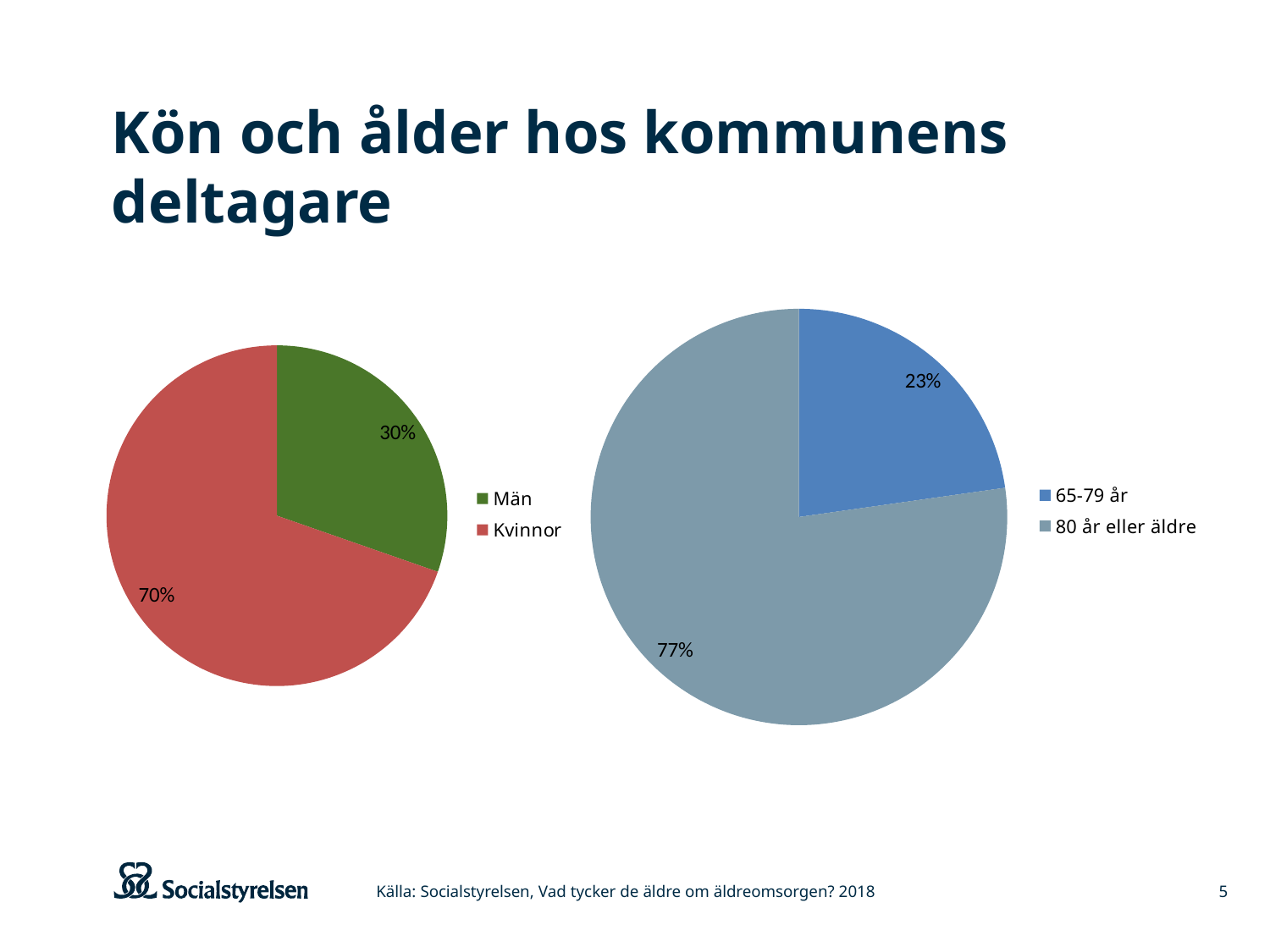
In the left pie chart, what colour is the Män slice? Green In the left pie chart, what share of participants are Kvinnor? 70% In the left pie chart, what share of participants are Män? 30% What type of chart is used on the right side of the slide? Pie chart In the right pie chart, what share of participants are 65-79 år? 23% How many slices does the left pie chart have? 2 In the right pie chart, which is larger: 65-79 år or 80 år eller äldre? 80 år eller äldre In the right pie chart, which category has the smallest slice? 65-79 år In the right pie chart, what share of participants are 80 år eller äldre? 77% In the right pie chart, what is the difference in percentage points between 80 år eller äldre and 65-79 år? 54 In the left pie chart, what is the difference in percentage points between Kvinnor and Män? 40 In the left pie chart, which category has the largest slice? Kvinnor